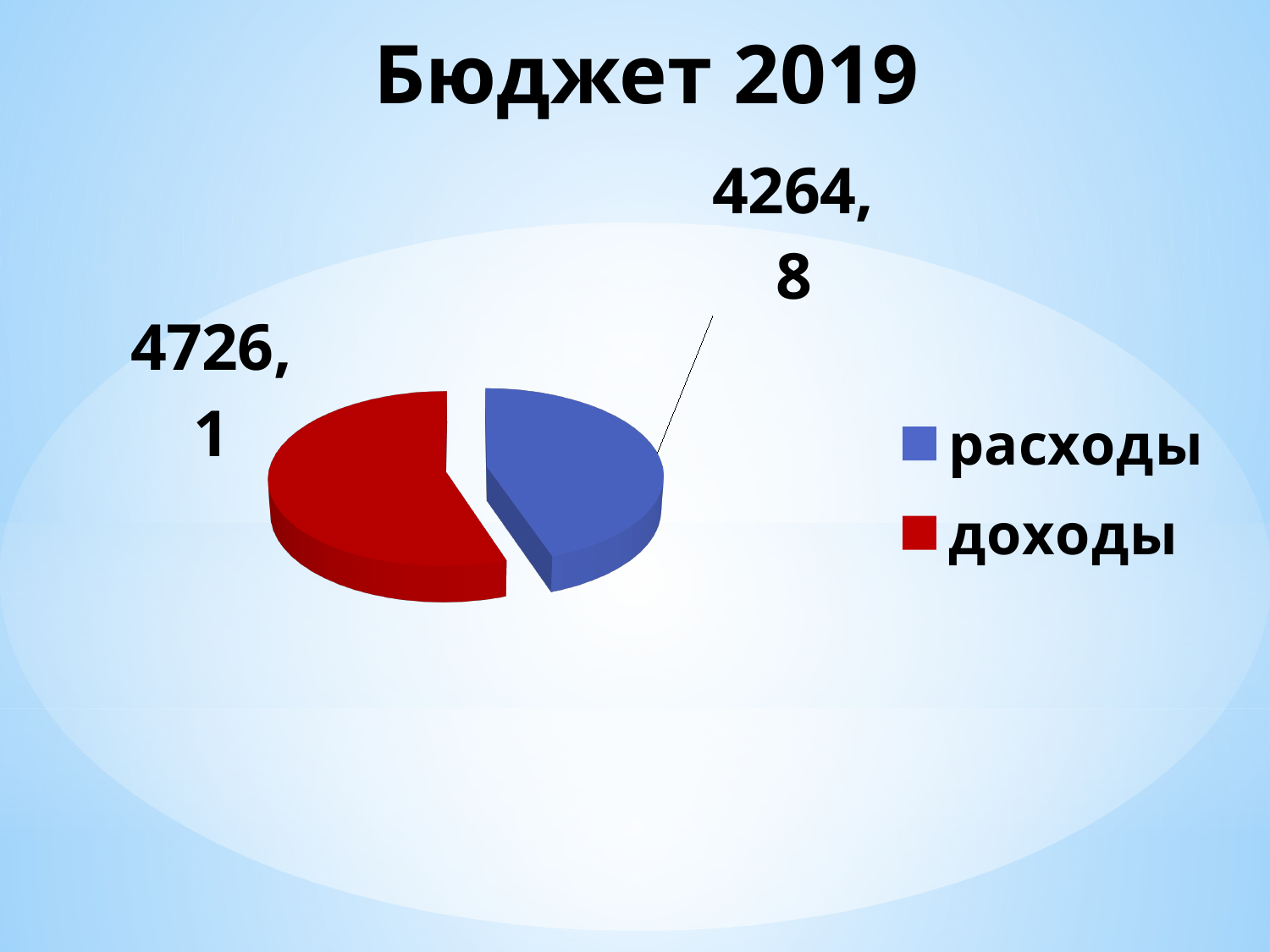
What is the value for доходы in the pie chart? 4726,1 Which category has the smallest slice in the pie chart? расходы What is the total of the two values shown in the pie chart? 8990,9 What kind of chart is shown on the slide? pie chart What is the title of the chart? Бюджет 2019 Which category has the larger value, расходы or доходы? доходы How many slices does the pie chart have? 2 How many entries does the legend list? 2 Which category has the largest slice in the pie chart? доходы What is the difference between the values for доходы and расходы? 461,3 What is the value for расходы in the pie chart? 4264,8 Which colour represents доходы in the pie chart? red